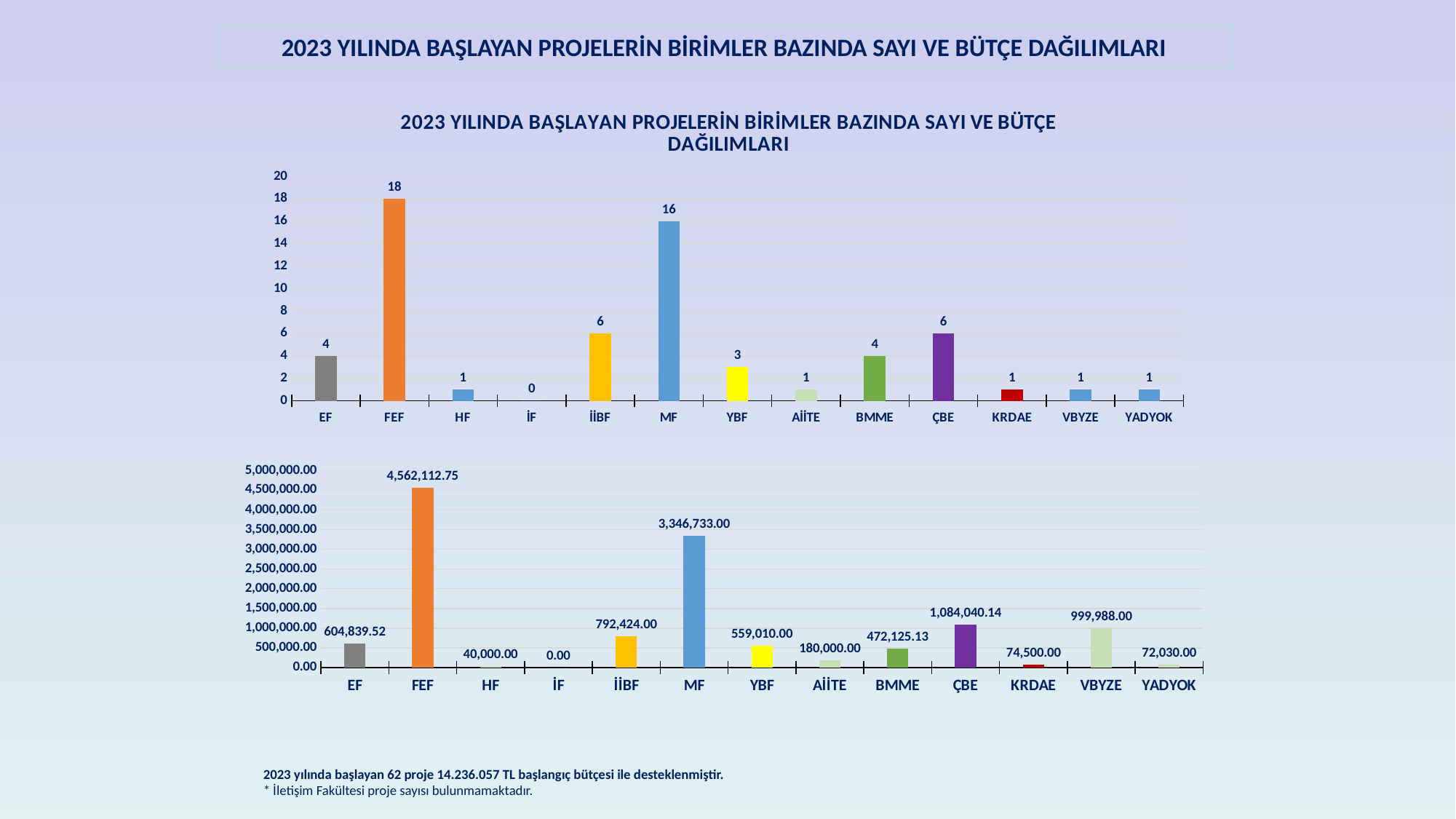
In the bottom chart, is the value for EF greater or less than 1,000,000.00? less In the top chart, how many projects does FEF have? 18 In the top chart, which unit has the lowest number of projects? İF In the bottom chart, what is the value for ÇBE? 1,084,040.14 In the bottom chart, which unit has the highest budget? FEF In the top chart, how many categories are shown on the x axis? 13 In the top chart, what is the difference between the values for FEF and MF? 2 In the bottom chart, what is the difference between the values for HF and KRDAE? 34,500.00 What kind of chart is the top chart? bar chart In the bottom chart, what is the value for MF? 3,346,733.00 In the bottom chart, which is larger, the value for VBYZE or the value for İİBF? VBYZE In the top chart, which unit has the highest number of projects? FEF